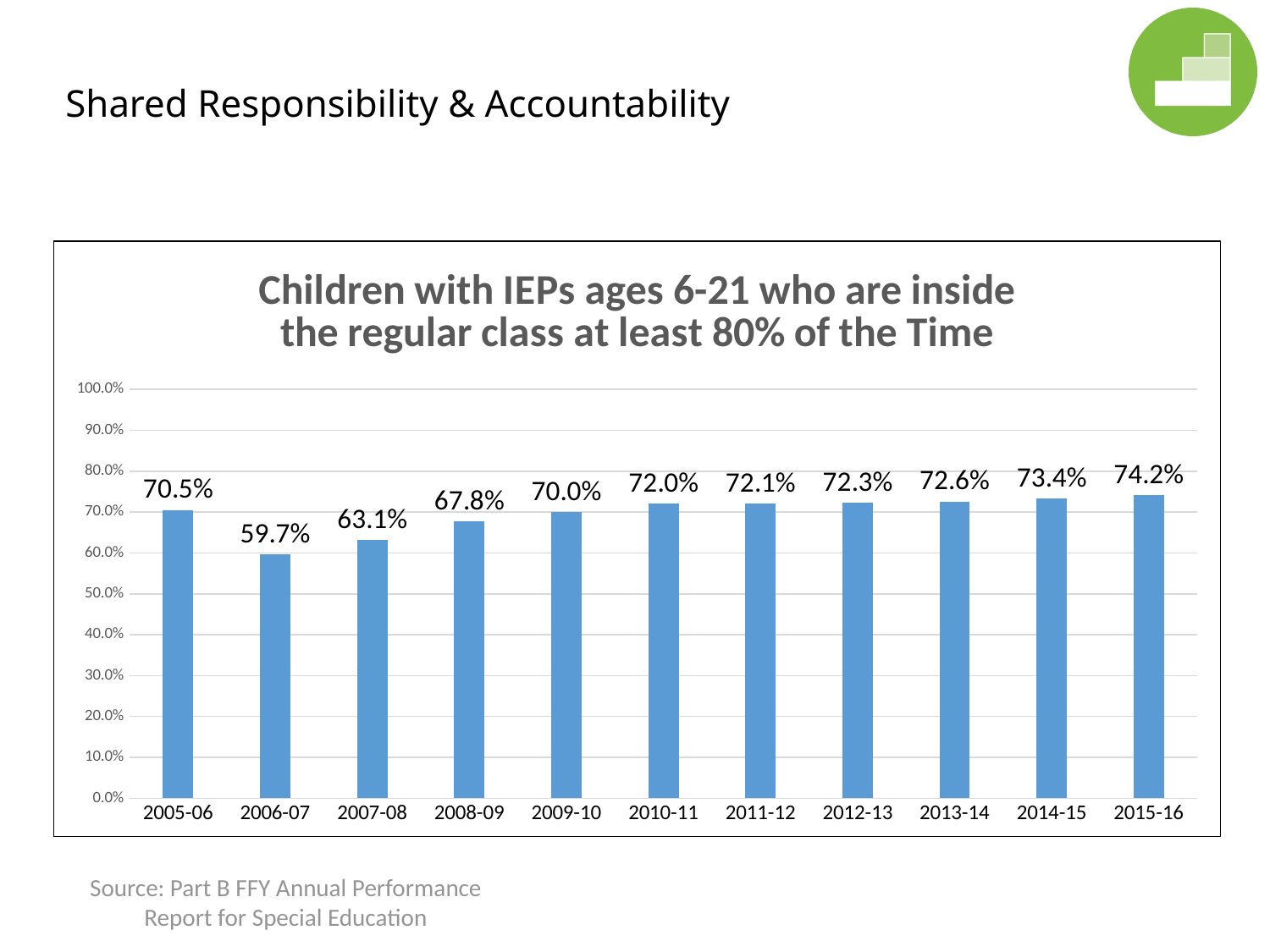
Which year has the highest value? 2015-16 What is the value for 2015-16? 74.2% Is the value for 2006-07 greater or less than 60.0%? less Which is larger, the value for 2005-06 or the value for 2009-10? 2005-06 What is the title of the chart? Children with IEPs ages 6-21 who are inside the regular class at least 80% of the Time Which year has the lowest value? 2006-07 How many years are shown on the x axis? 11 What is the difference between the values for 2015-16 and 2006-07? 14.5% What is the value for 2010-11? 72.0% What is the difference between the values for 2008-09 and 2007-08? 4.7% What is the value for 2005-06? 70.5% What kind of chart is this? bar chart